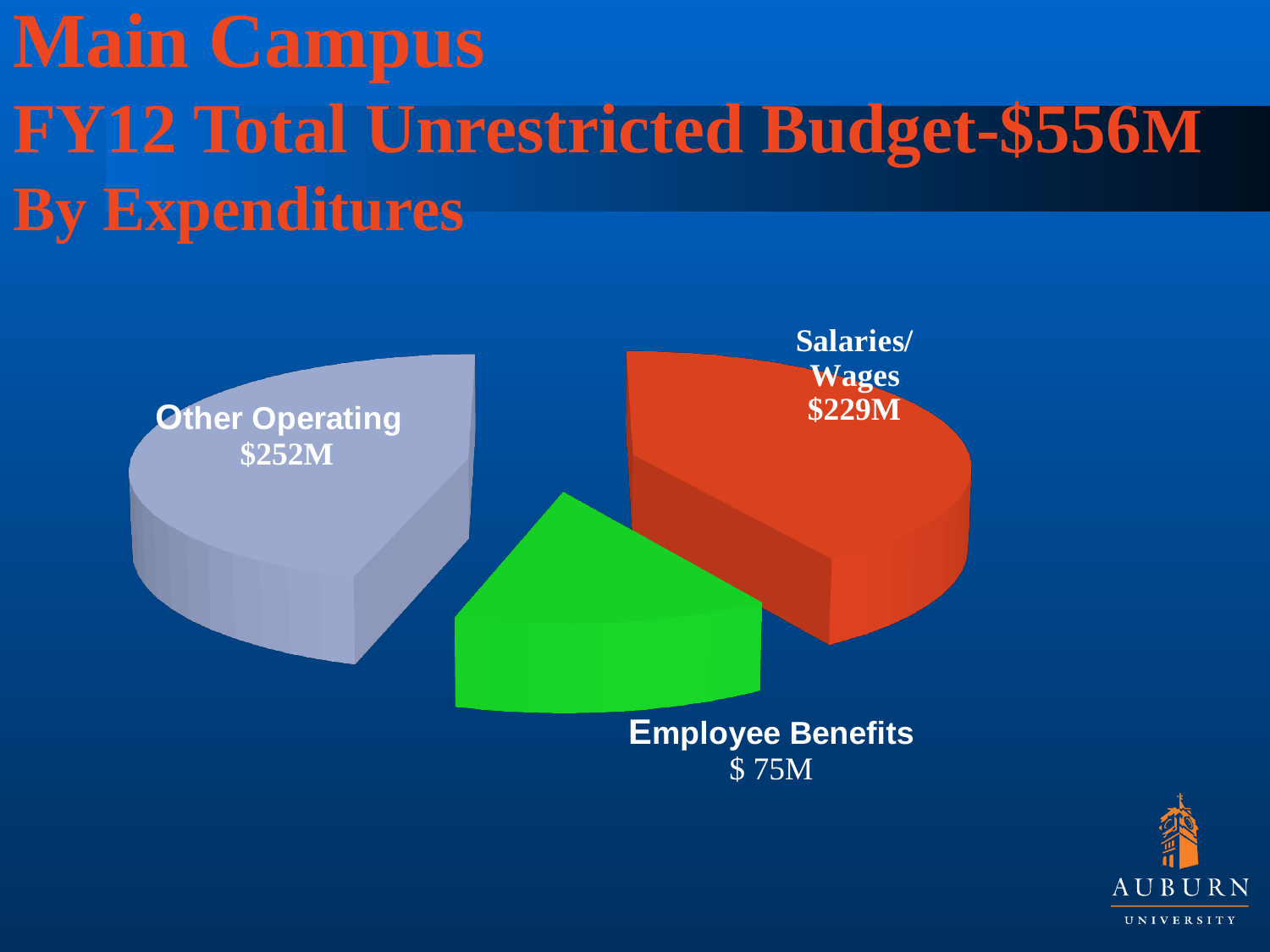
How many slices does the pie chart have? 3 What is the value for Other Operating? $252M What colour is the Employee Benefits slice? green Which is larger, Salaries/Wages or Employee Benefits? Salaries/Wages What is the difference between Salaries/Wages and Employee Benefits? $154M What is the value for Employee Benefits? $75M What kind of chart is shown on the slide? pie chart What is the difference between Other Operating and Salaries/Wages? $23M Which expenditure category has the largest slice? Other Operating Which expenditure category has the smallest slice? Employee Benefits What is the total of the three slices in the pie chart? $556M What is the value for Salaries/Wages? $229M